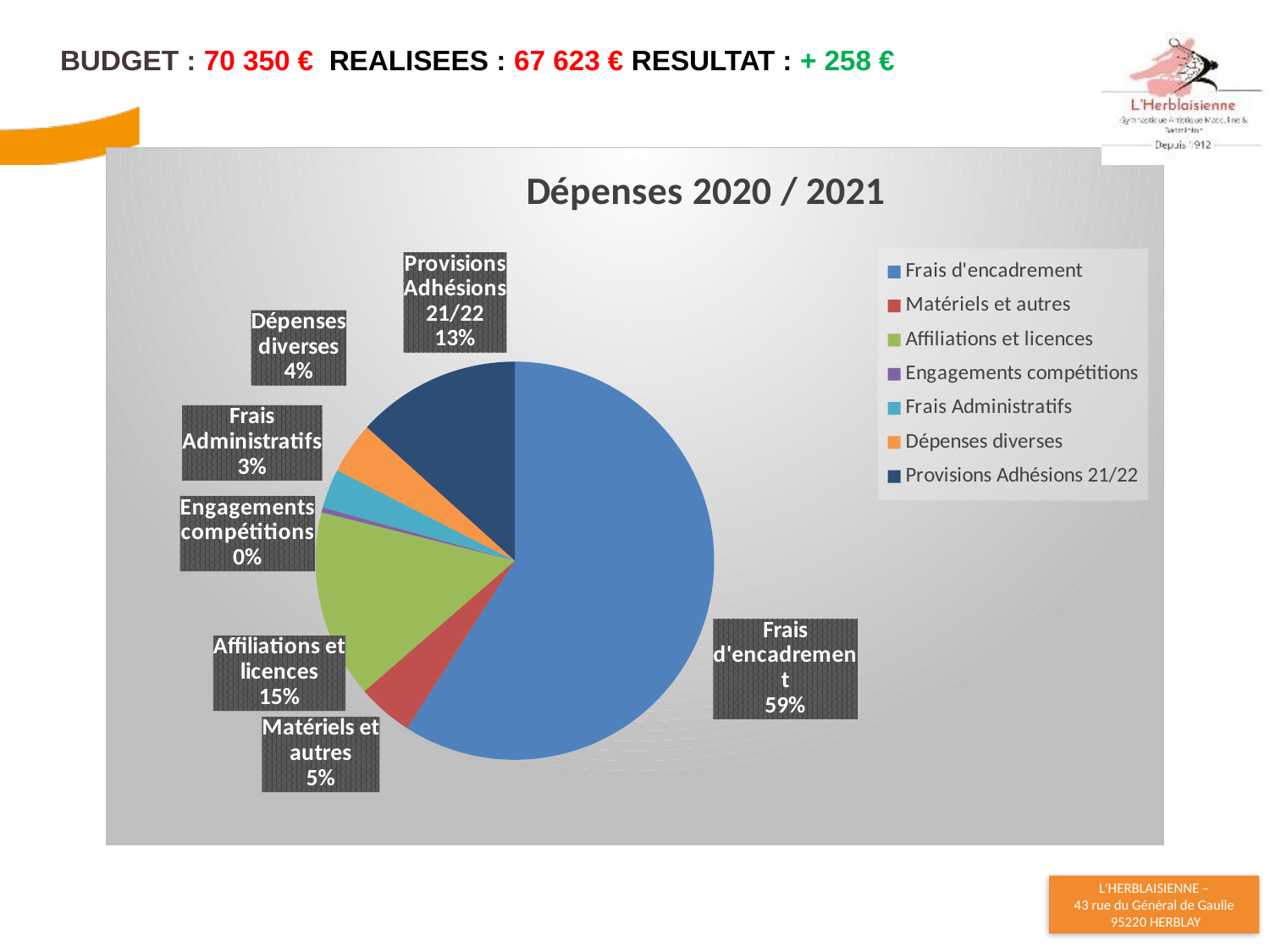
Which category has the smallest share of the pie? Engagements compétitions What percentage is shown for Matériels et autres? 5% Which category has the largest share of the pie? Frais d'encadrement What is the title of the chart? Dépenses 2020 / 2021 Which is larger, Dépenses diverses or Frais Administratifs? Dépenses diverses What percentage is shown for Provisions Adhésions 21/22? 13% How many categories does the legend list? 7 What type of chart is shown on the slide? Pie chart What percentage is shown for Affiliations et licences? 15% What share of the pie does Frais d'encadrement represent? 59% What percentage is shown for Engagements compétitions? 0% What is the difference in percentage points between Affiliations et licences and Provisions Adhésions 21/22? 2 percentage points